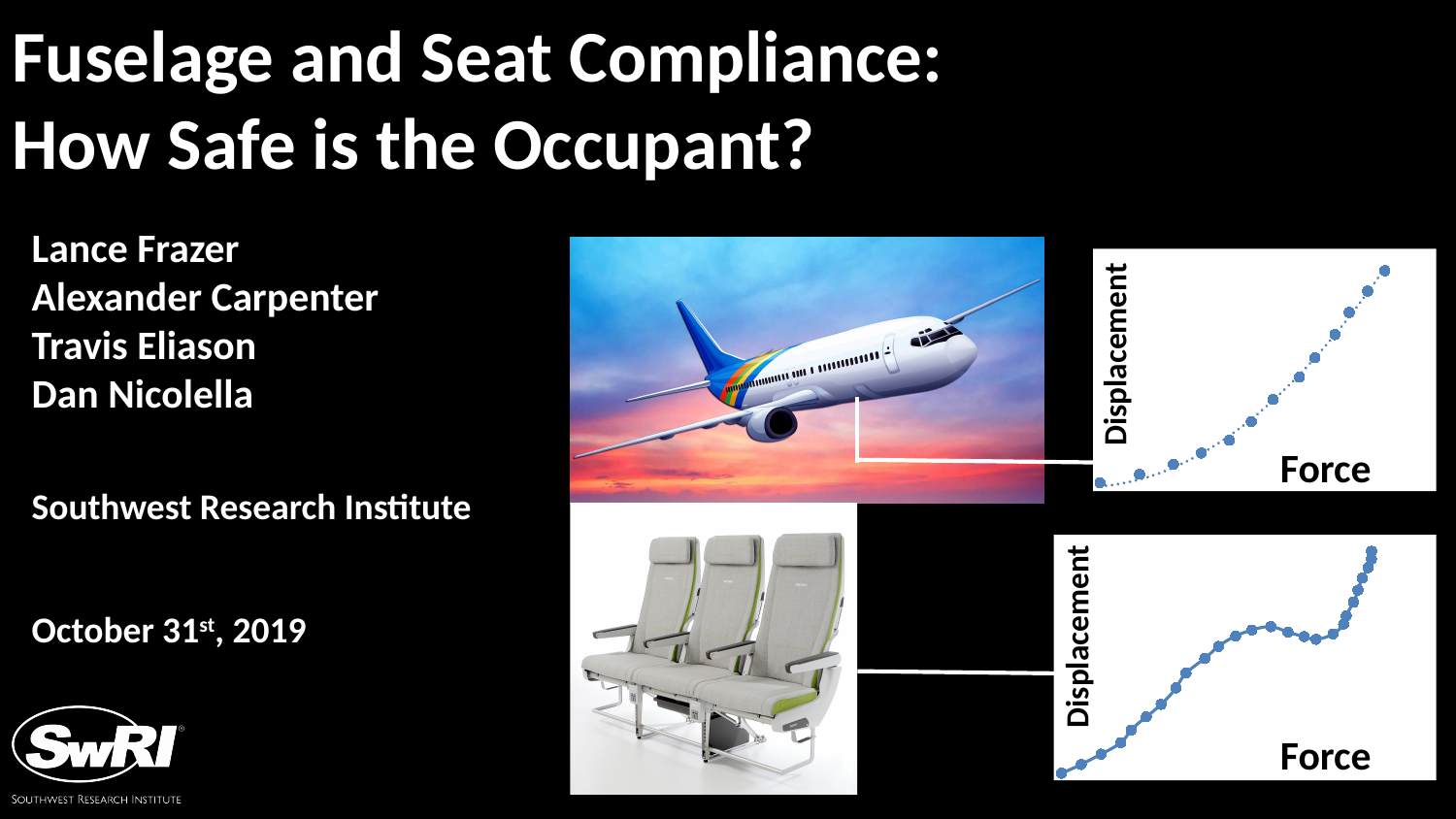
What is the label on the y axis of the lower-right chart? Displacement What is the label on the x axis of the upper-right chart? Force What kind of chart is the lower-right chart on the slide? scatter chart In the upper-right chart, does displacement rise or fall as force increases along the x axis? rise Which of the two charts shows a flat plateau in the middle of the curve before rising steeply, the upper-right or the lower-right chart? lower-right How many charts are shown on the slide? 2 What kind of chart is the upper-right chart on the slide? scatter chart In the lower-right chart, does displacement overall rise or fall from the left end to the right end of the x axis? rise